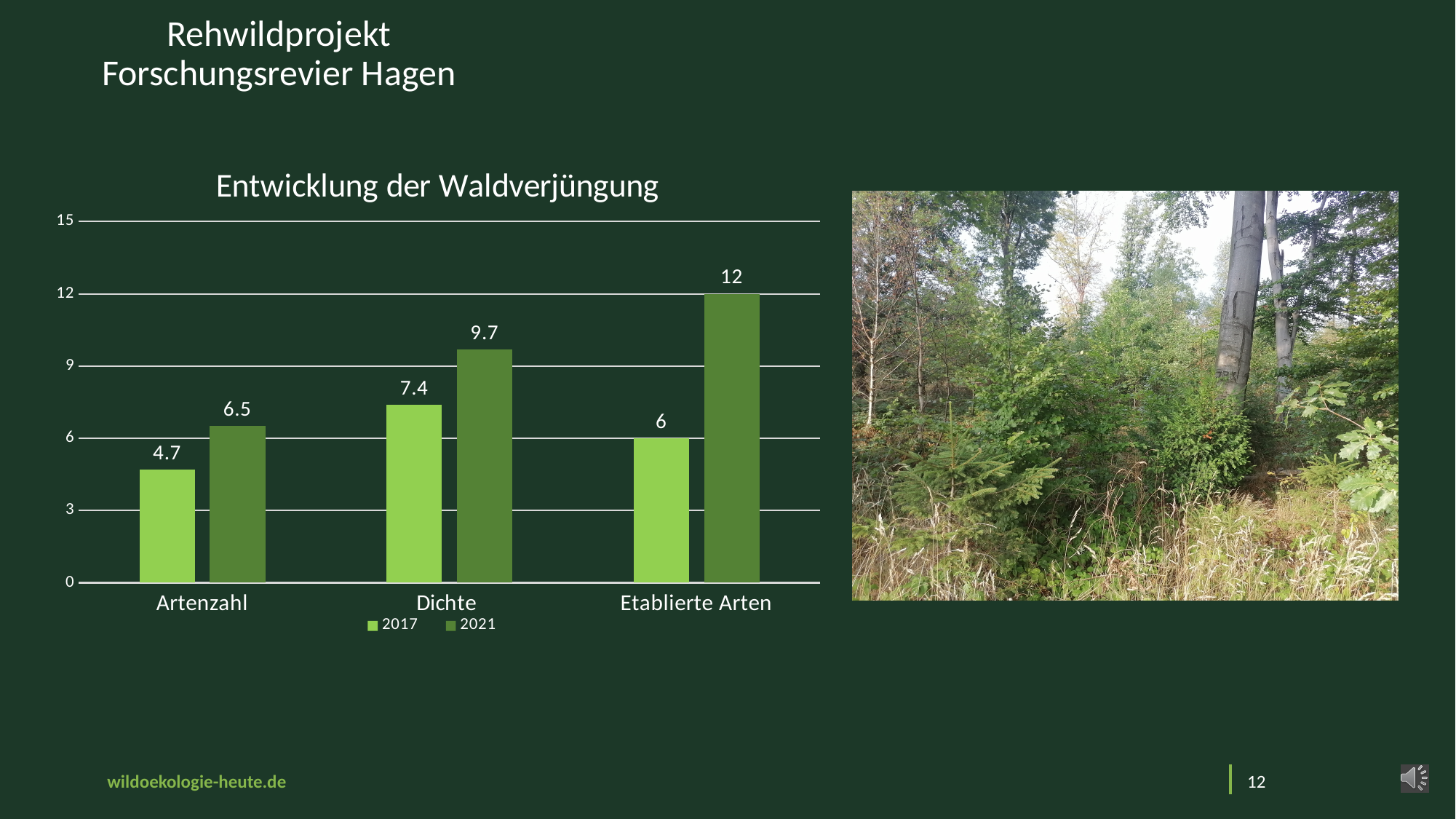
What is the value for Artenzahl in 2017? 4.7 Which is larger, the 2017 value for Dichte or the 2021 value for Artenzahl? 2017 value for Dichte What is the difference between the 2021 and 2017 values for Dichte? 2.3 Which category has the lowest 2017 value? Artenzahl Which category has the highest 2021 value? Etablierte Arten How many series does the legend list? 2 What is the difference between the 2021 and 2017 values for Etablierte Arten? 6 What is the title of the chart? Entwicklung der Waldverjüngung What is the value for Etablierte Arten in 2021? 12 How many categories are shown on the x axis? 3 What is the value for Dichte in 2021? 9.7 What kind of chart is shown? Bar chart